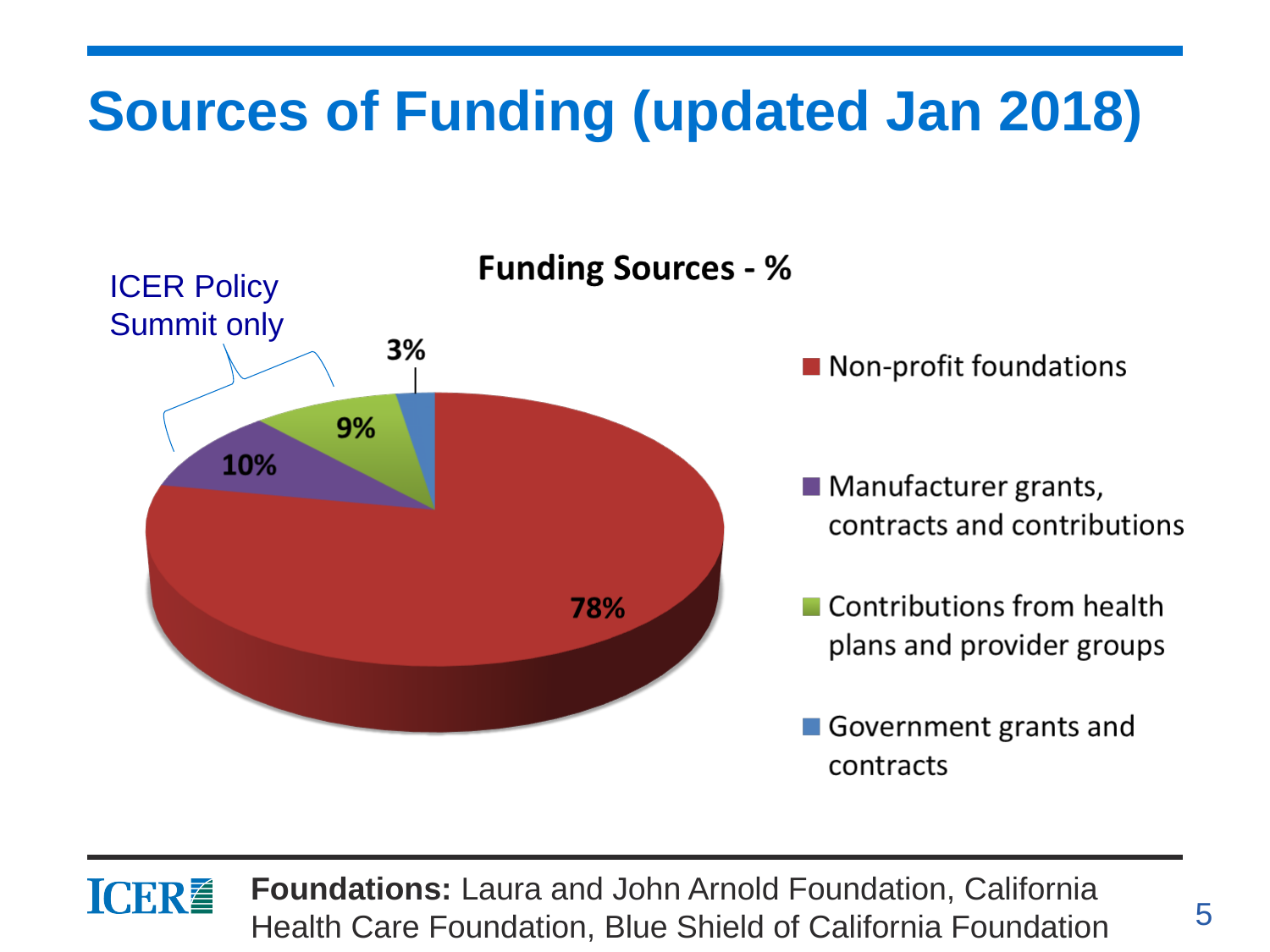
How many entries does the legend list? 4 Which is larger: the share for manufacturer grants, contracts and contributions or the share for government grants and contracts? Manufacturer grants, contracts and contributions Which funding source has the largest share? Non-profit foundations What percentage of funding comes from contributions from health plans and provider groups? 9% What percentage of funding comes from non-profit foundations? 78% Which funding source has the smallest share? Government grants and contracts How many slices does the pie chart have? 4 What is the chart's title? Funding Sources - % What percentage of funding comes from government grants and contracts? 3% What percentage of funding comes from manufacturer grants, contracts and contributions? 10% What is the difference in percentage points between non-profit foundations and manufacturer grants, contracts and contributions? 68 What kind of chart is shown on the slide? Pie chart